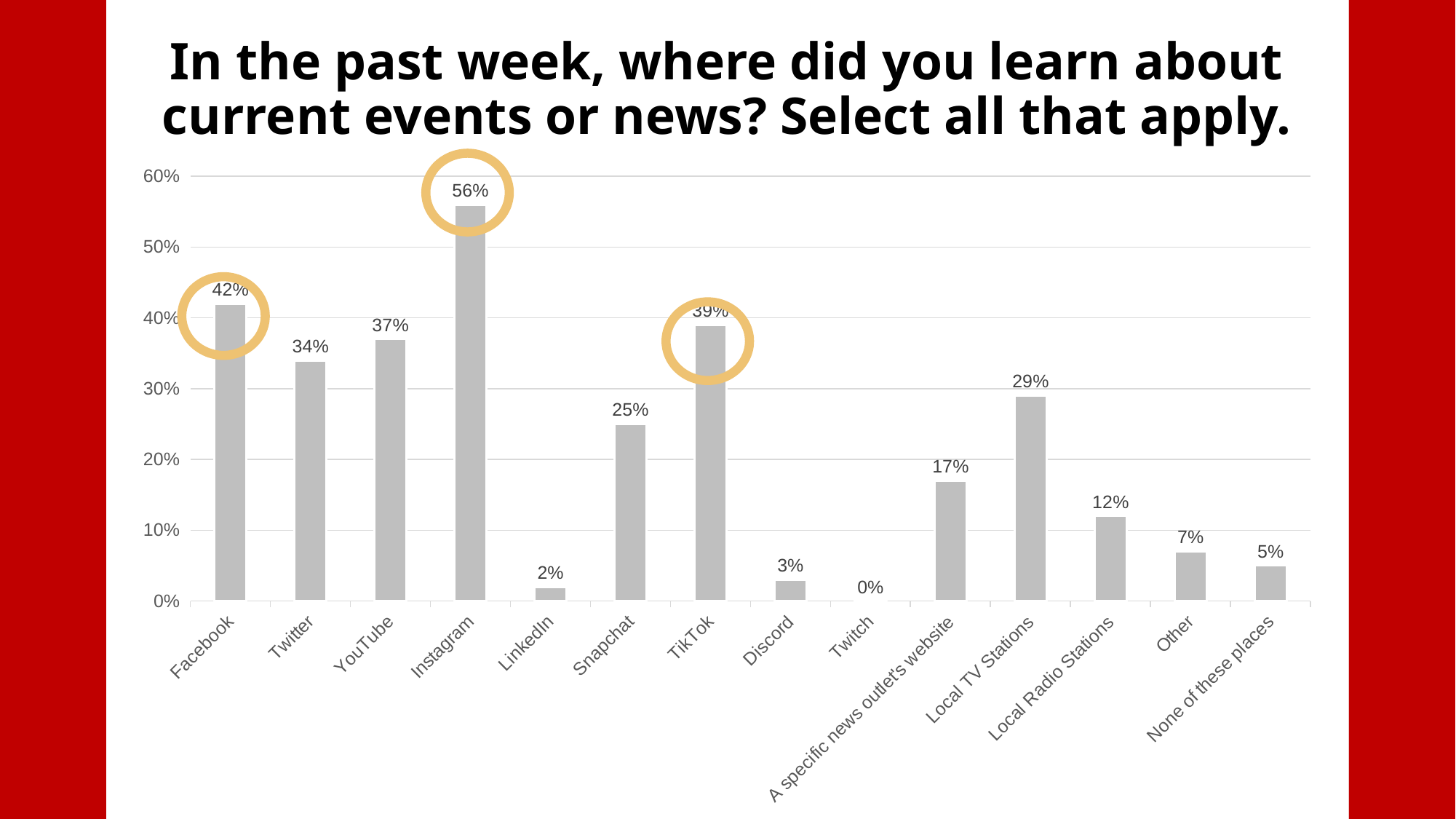
What is the difference between the Facebook and TikTok percentages? 3% What is the value shown for Local TV Stations? 29% What is the difference between the Local TV Stations and Local Radio Stations percentages? 17% Is the value for Snapchat greater or less than 30%? less How many categories are shown on the x axis? 14 Which is larger, the value for YouTube or the value for Twitter? YouTube Which source has the lowest percentage? Twitch What kind of chart is shown on the slide? bar chart Which source has the highest percentage? Instagram What percentage is shown for LinkedIn? 2% What percentage of respondents learned about news from Instagram? 56% How many bars are highlighted with orange circles? 3